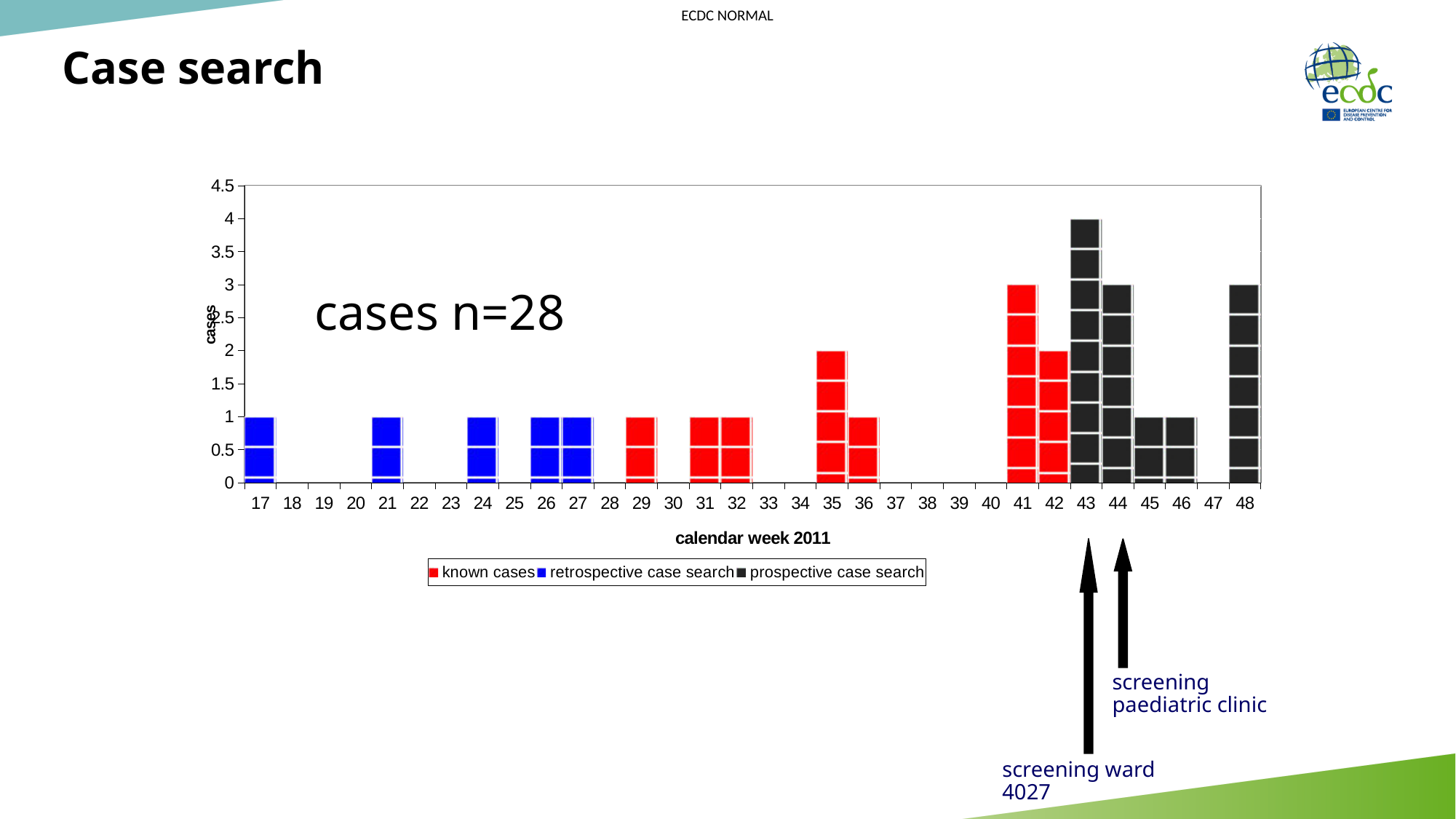
How many cases are shown for calendar week 48? 3 Which series is shown in blue according to the legend? retrospective case search How many cases are shown for calendar week 41? 3 Which has more cases, calendar week 42 or calendar week 44? 44 How many cases are shown for calendar week 43? 4 What is the difference in cases between calendar week 43 and calendar week 44? 1 How many calendar weeks are labelled on the x axis? 32 Is the value for calendar week 43 greater or less than 3.5? greater Which calendar week has the highest number of cases? 43 What kind of chart is shown on the slide? bar chart How many cases are shown for calendar week 35? 2 How many series does the legend list? 3